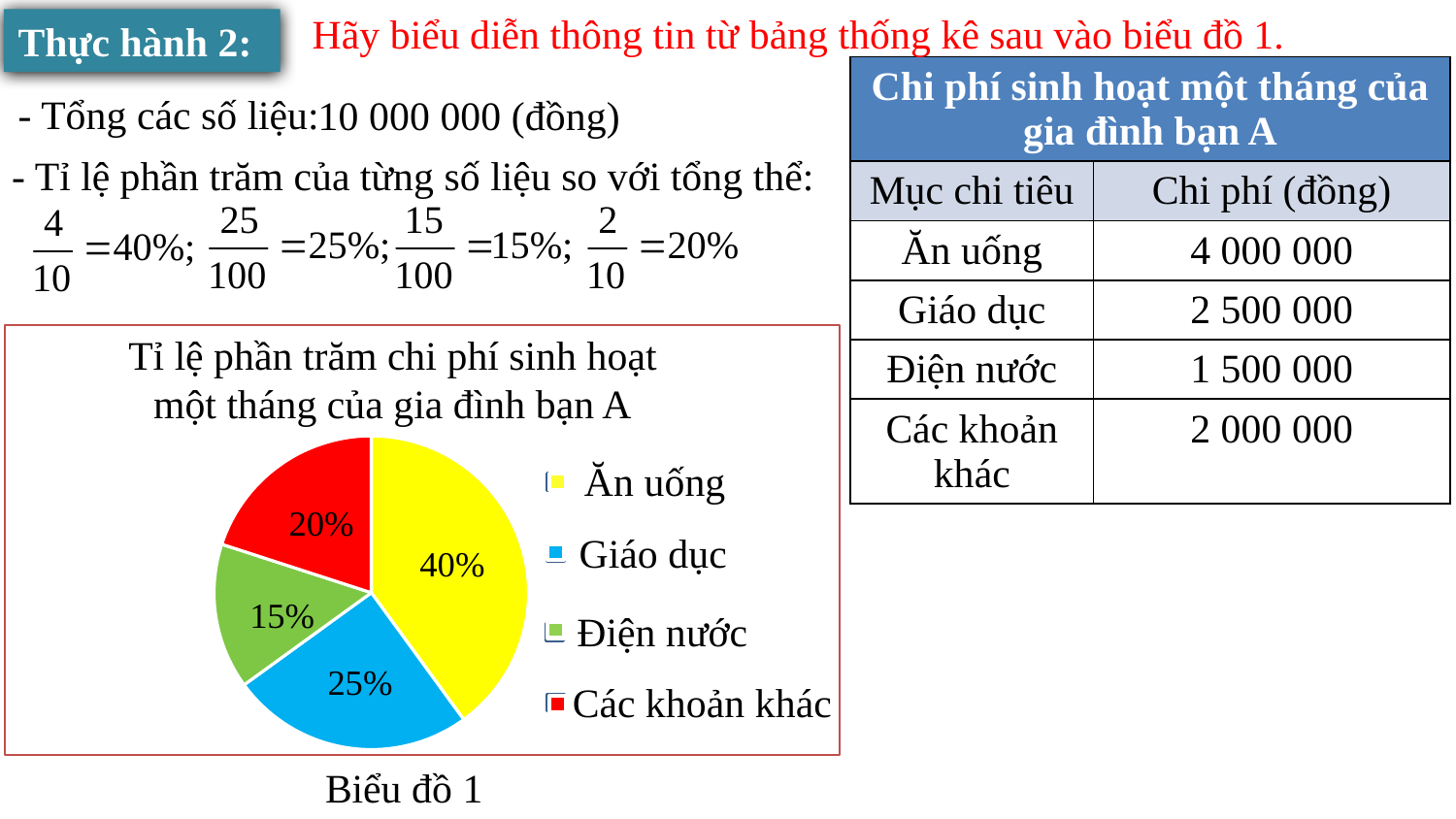
What colour is the Giáo dục slice in the pie chart? blue What kind of chart is shown on the slide? pie chart What percentage of the pie chart is labelled for Ăn uống? 40% What percentage of the pie chart is labelled for Điện nước? 15% How many slices does the pie chart have? 4 What percentage of the pie chart is labelled for Giáo dục? 25% Which category has the largest slice in the pie chart? Ăn uống What is the title of the pie chart? Tỉ lệ phần trăm chi phí sinh hoạt một tháng của gia đình bạn A Which category has the smallest slice in the pie chart? Điện nước Which slice is larger, Các khoản khác or Điện nước? Các khoản khác What percentage of the pie chart is labelled for Các khoản khác? 20% What is the difference in percentage points between the Ăn uống slice and the Giáo dục slice? 15%